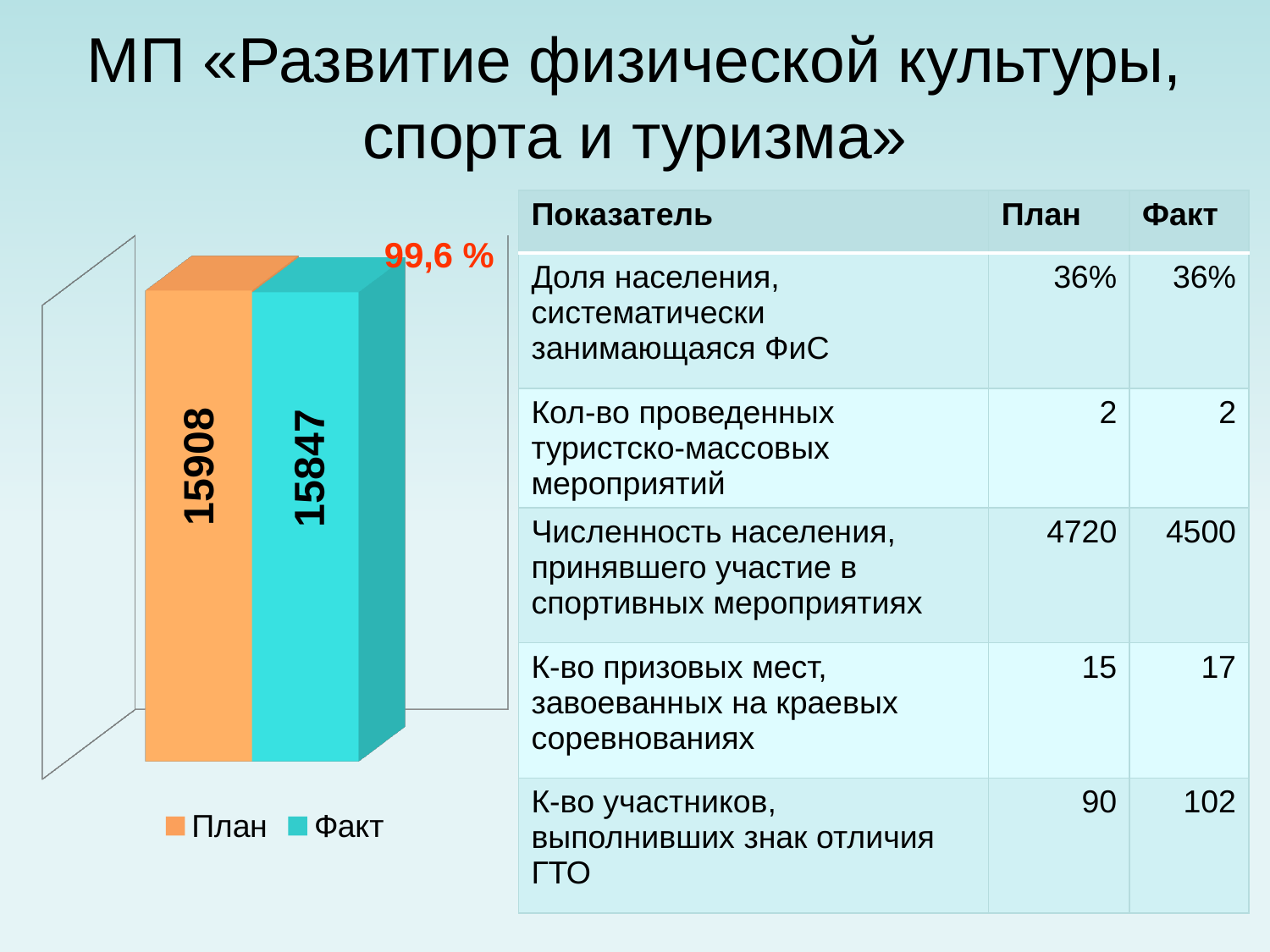
Which bar in the chart has the lowest value? Факт How many bars are plotted in the chart? 2 Which series has the higher value in the chart, План or Факт? План How many series does the chart legend list? 2 Which bar in the chart has the highest value? План What percentage is printed in red above the bars in the chart? 99,6 % What kind of chart is shown on the left of the slide? Bar chart What is the difference between the План and Факт values in the chart? 61 What is the value of the Факт bar in the chart? 15847 What colour is the Факт bar in the chart? Turquoise What is the value of the План bar in the chart? 15908